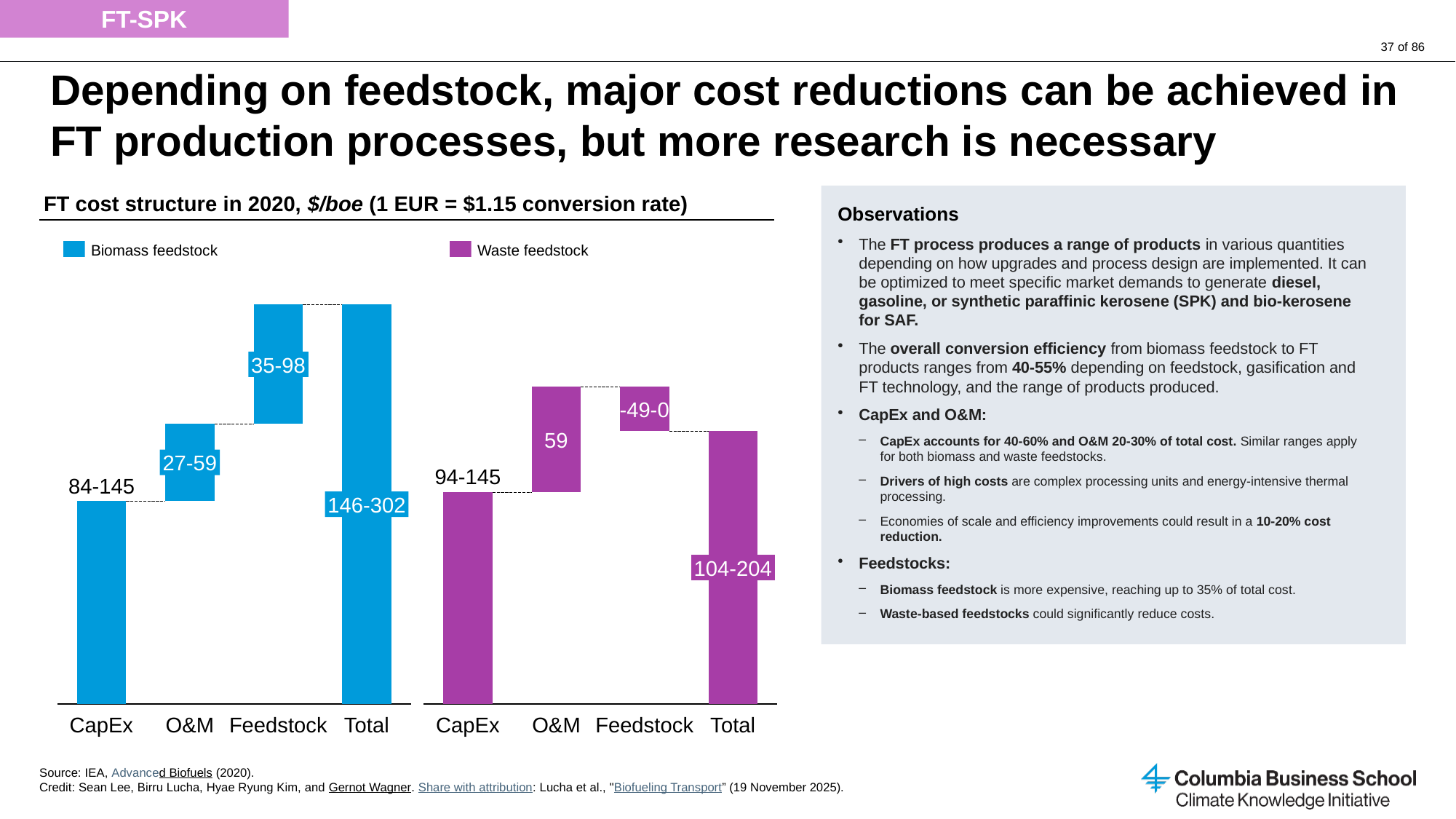
What is the O&M value shown for the Biomass feedstock series? 27-59 What is the CapEx value shown for the Biomass feedstock series? 84-145 Which series has the higher Total cost, Biomass feedstock or Waste feedstock? Biomass feedstock What is the O&M value shown for the Waste feedstock series? 59 How many cost categories are shown on the x axis for each feedstock series? 4 What is the CapEx value shown for the Waste feedstock series? 94-145 What is the Total value shown for the Biomass feedstock series? 146-302 What is the Feedstock value shown for the Waste feedstock series? -49-0 What is the Total value shown for the Waste feedstock series? 104-204 How many series does the legend list? 2 What is the title of the chart? FT cost structure in 2020, $/boe (1 EUR = $1.15 conversion rate) What is the Feedstock value shown for the Biomass feedstock series? 35-98